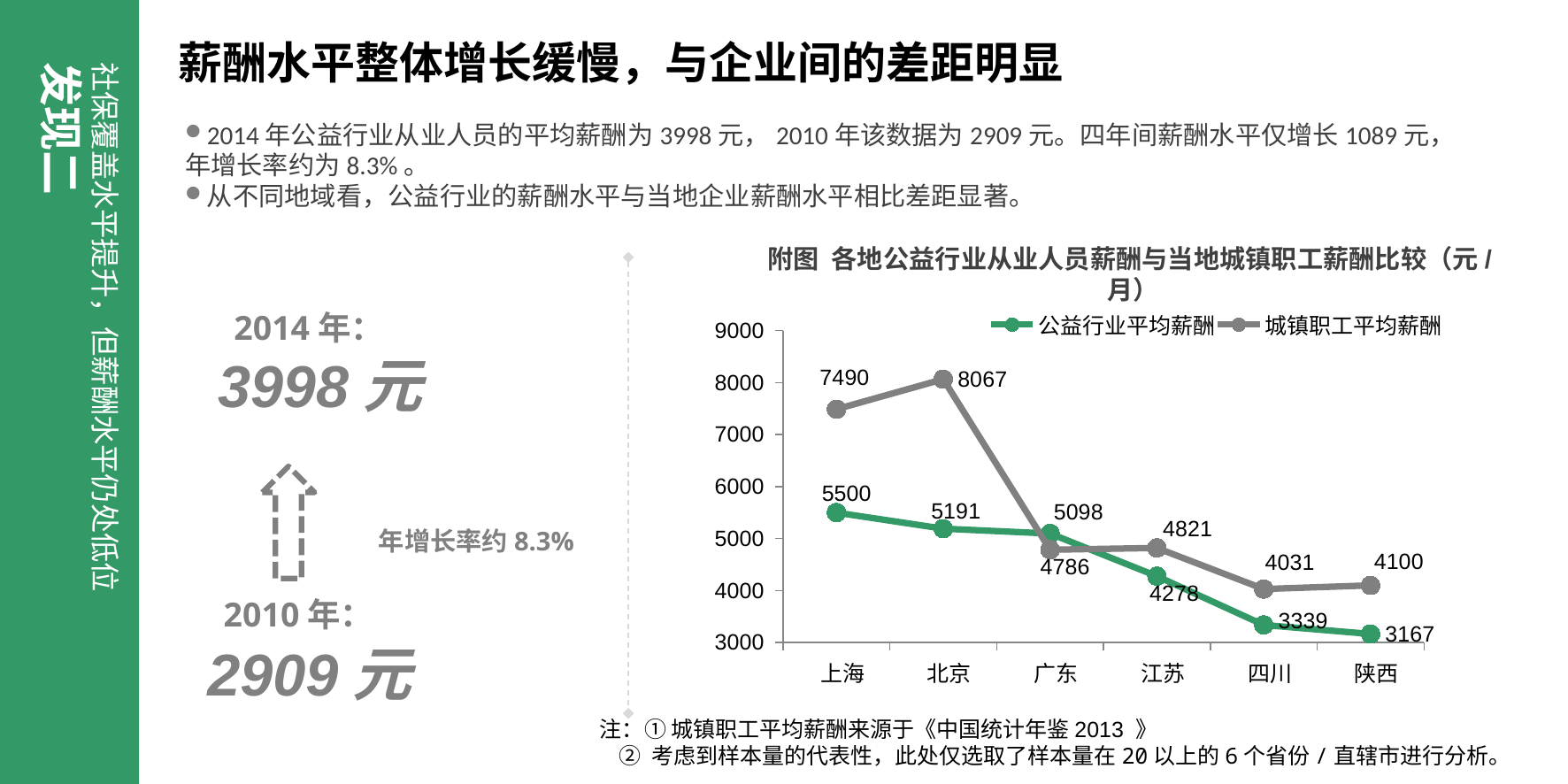
What is the 城镇职工平均薪酬 value for 北京? 8067 What is the difference between 城镇职工平均薪酬 and 公益行业平均薪酬 for 上海? 1990 How many regions are plotted along the x axis of the chart? 6 What is the 公益行业平均薪酬 value for 陕西? 3167 What type of chart is shown on the slide? line chart What is the 公益行业平均薪酬 value for 上海? 5500 What is the title of the chart? 附图 各地公益行业从业人员薪酬与当地城镇职工薪酬比较（元 / 月） Does the 公益行业平均薪酬 series rise or fall from 上海 to 陕西 along the x axis? fall For 广东, which is larger: 公益行业平均薪酬 or 城镇职工平均薪酬? 公益行业平均薪酬 Which region has the highest 城镇职工平均薪酬? 北京 Which region has the lowest 公益行业平均薪酬? 陕西 How many series does the chart legend list? 2